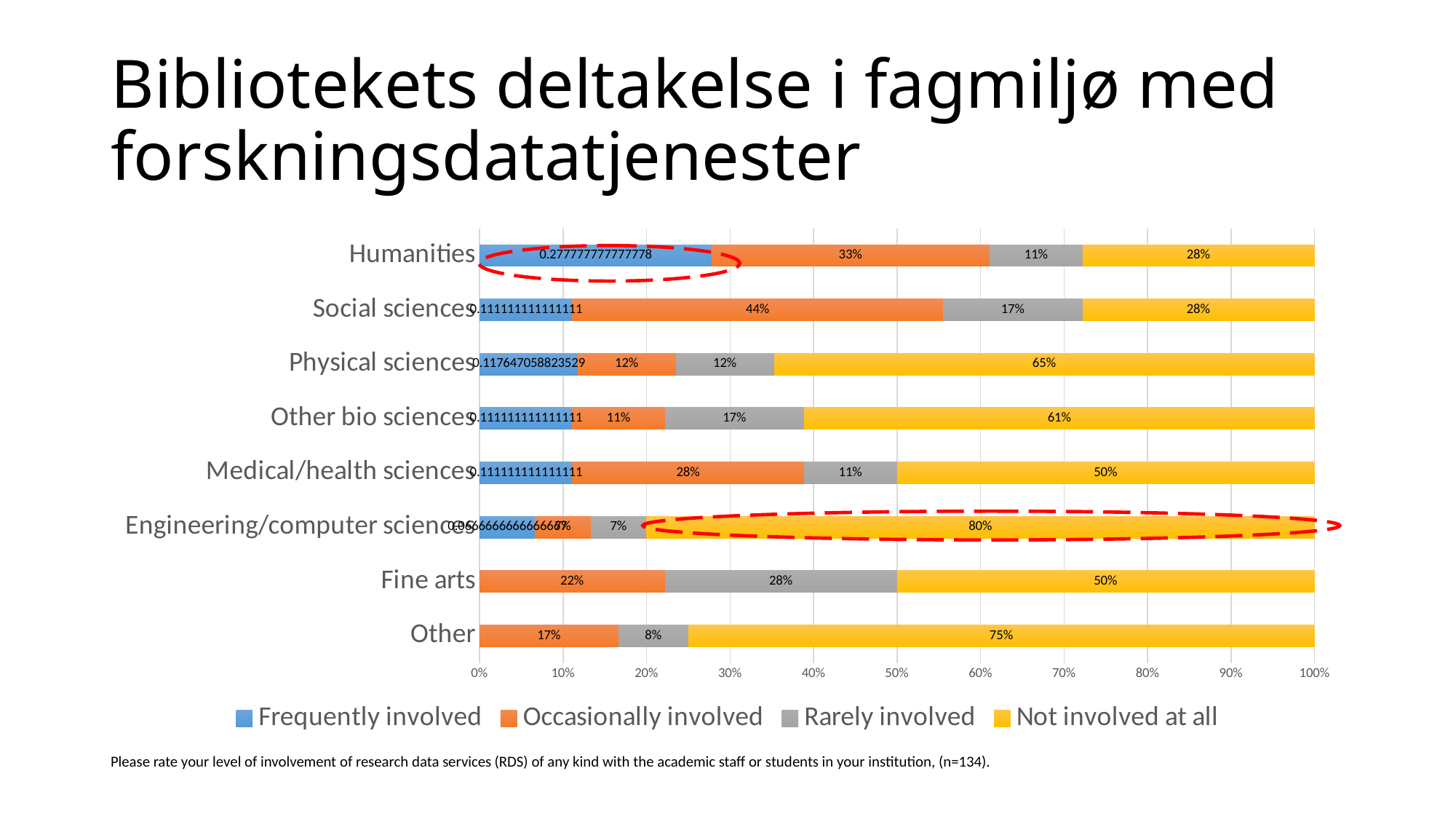
What is the 'Occasionally involved' value for Social sciences? 44% How many series does the legend list? 4 What is the difference between the 'Not involved at all' values for Physical sciences and Other bio sciences? 4 percentage points What is the 'Not involved at all' value for Other? 75% What is the 'Rarely involved' value for Fine arts? 28% Which category has the highest 'Not involved at all' value? Engineering/computer sciences Is the 'Frequently involved' value for Humanities greater or less than 20%? greater What is the 'Not involved at all' value for Engineering/computer sciences? 80% What kind of chart is shown on the slide? Stacked bar chart How many categories (disciplines) are shown on the chart? 8 Which category has the highest 'Occasionally involved' value? Social sciences Which has the larger 'Rarely involved' value, Fine arts or Other? Fine arts